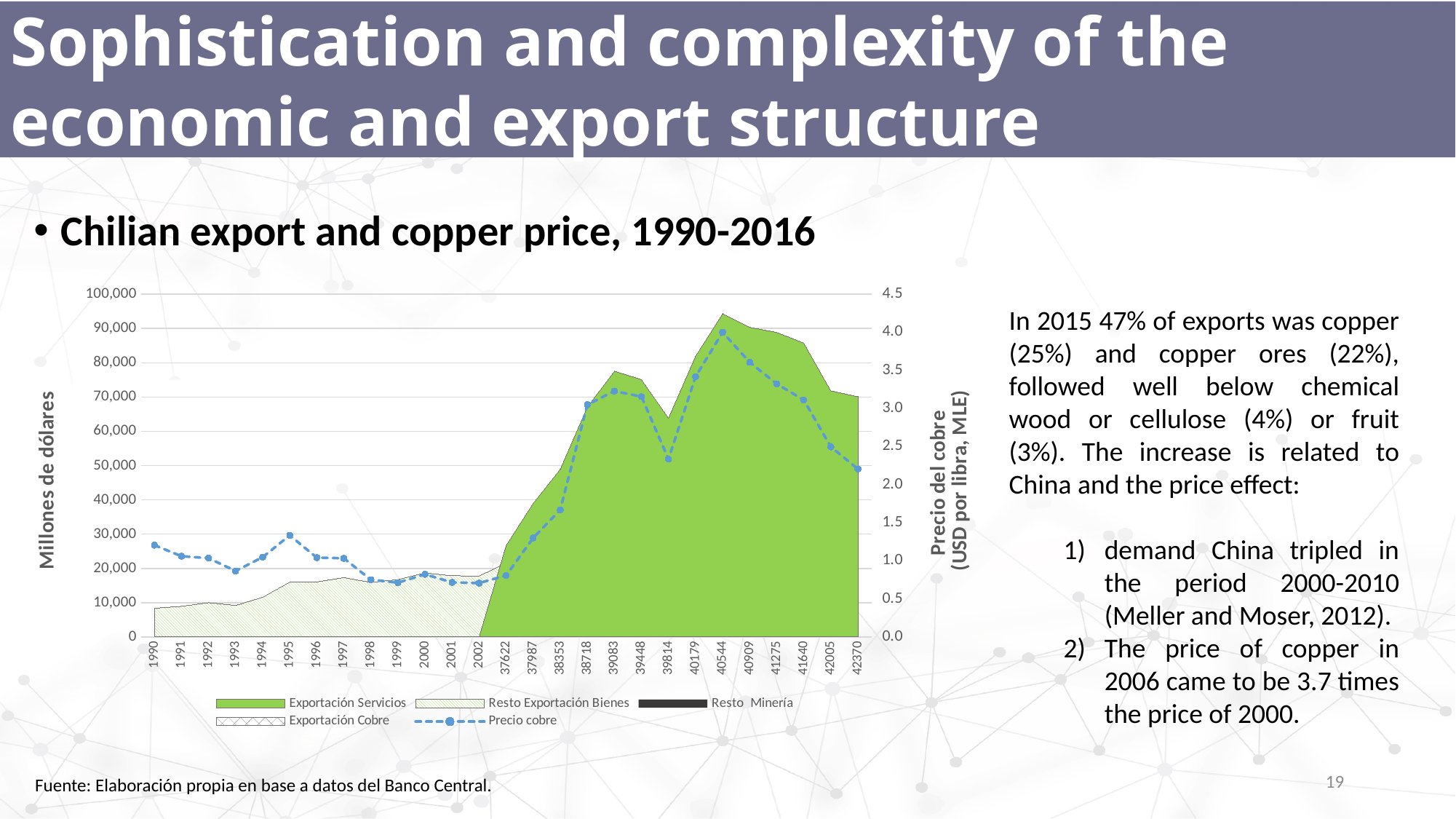
Does the Precio cobre line rise or fall between 40544 and 42370? fall Which is larger, the Precio cobre value at 40544 or in 1995? 40544 What is the title of the left vertical axis of the chart? Millones de dólares Is the Precio cobre value in 1990 greater or less than 1.5 on the right axis? less What kind of chart is shown on the slide? A combination chart of stacked areas with a dashed line Is the Precio cobre value at 40544 greater or less than 3.5 on the right axis? greater Is the total export value at 40544 greater or less than 90,000 on the left axis? greater How many series does the chart's legend list? 5 At which x-axis label does the Precio cobre line reach its highest value? 40544 Which legend entry is drawn as a dashed line with markers? Precio cobre How many points are labelled along the x axis of the chart? 27